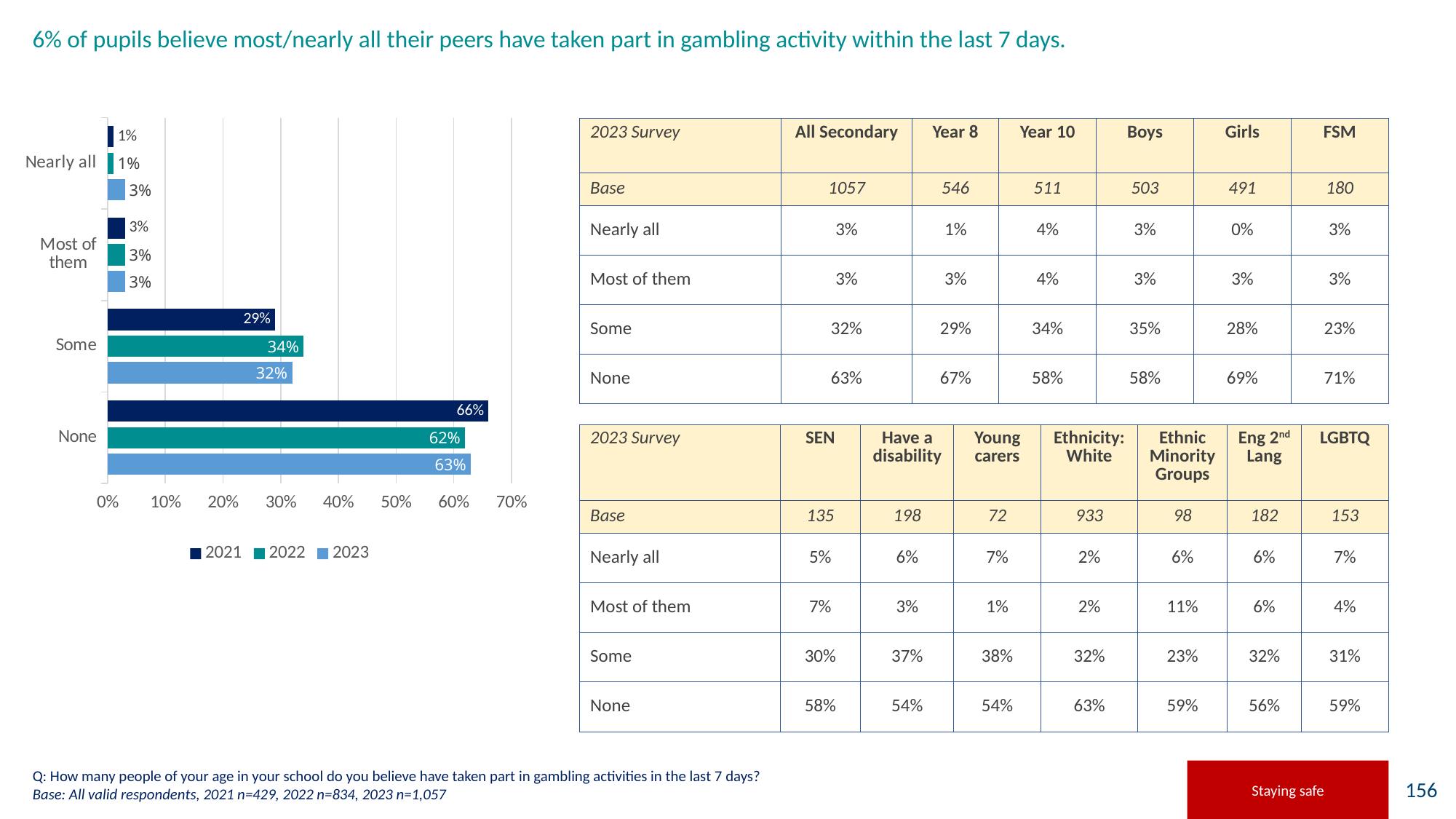
Which series is shown in the darkest blue colour in the chart? 2021 Which is larger for 'Some': the 2021 value or the 2023 value? 2023 What is the 2023 value for 'None' in the chart? 63% What kind of chart is shown on the slide? bar chart What is the 2022 value for 'Some' in the chart? 34% How many categories are shown on the chart's vertical axis? 4 Which category has the lowest value for the 2023 series? Most of them and Nearly all (both 3%) How many series does the chart legend list? 3 Is the 2021 value for 'None' greater or less than 60%? greater Which category has the highest value for the 2021 series? None What is the 2021 value for 'Nearly all' in the chart? 1% What is the difference between the 2021 and 2022 values for 'None'? 4%